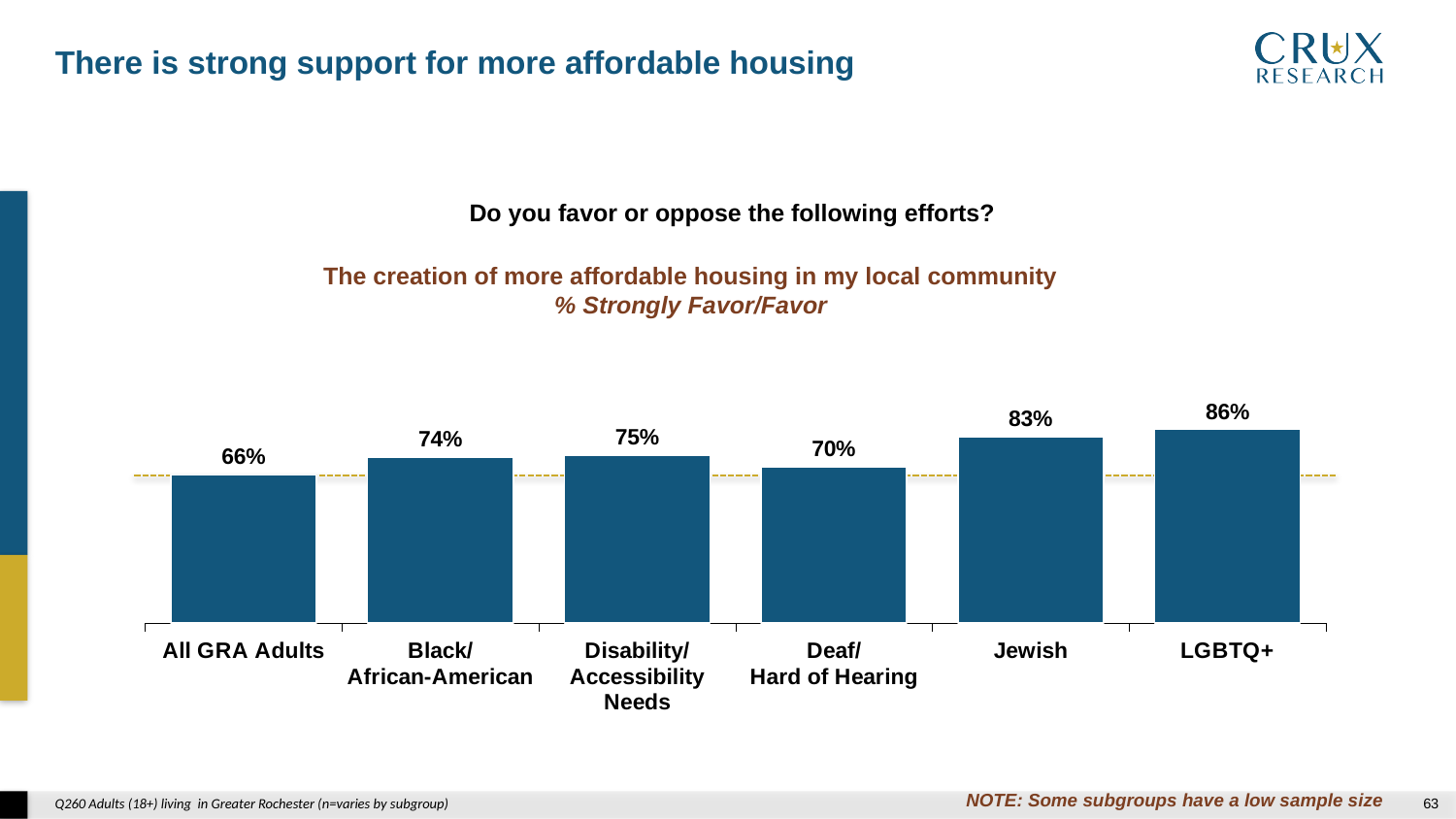
What is the value shown for the Deaf/Hard of Hearing subgroup? 70% How many subgroups (bars) are shown on the chart? 6 What is the value shown for the Jewish subgroup? 83% What is the value shown for the Black/African-American subgroup? 74% What percentage of All GRA Adults strongly favor or favor the creation of more affordable housing in their local community? 66% Which subgroup has the highest percentage favoring more affordable housing? LGBTQ+ What kind of chart is shown on the slide? Bar chart What measure does the chart report, according to the subtitle? % Strongly Favor/Favor What is the difference between the LGBTQ+ value and the All GRA Adults value? 20% Which category has the lowest percentage on the chart? All GRA Adults What is the difference between the Disability/Accessibility Needs value and the Black/African-American value? 1% Which is larger, the value for Jewish or the value for Deaf/Hard of Hearing? Jewish